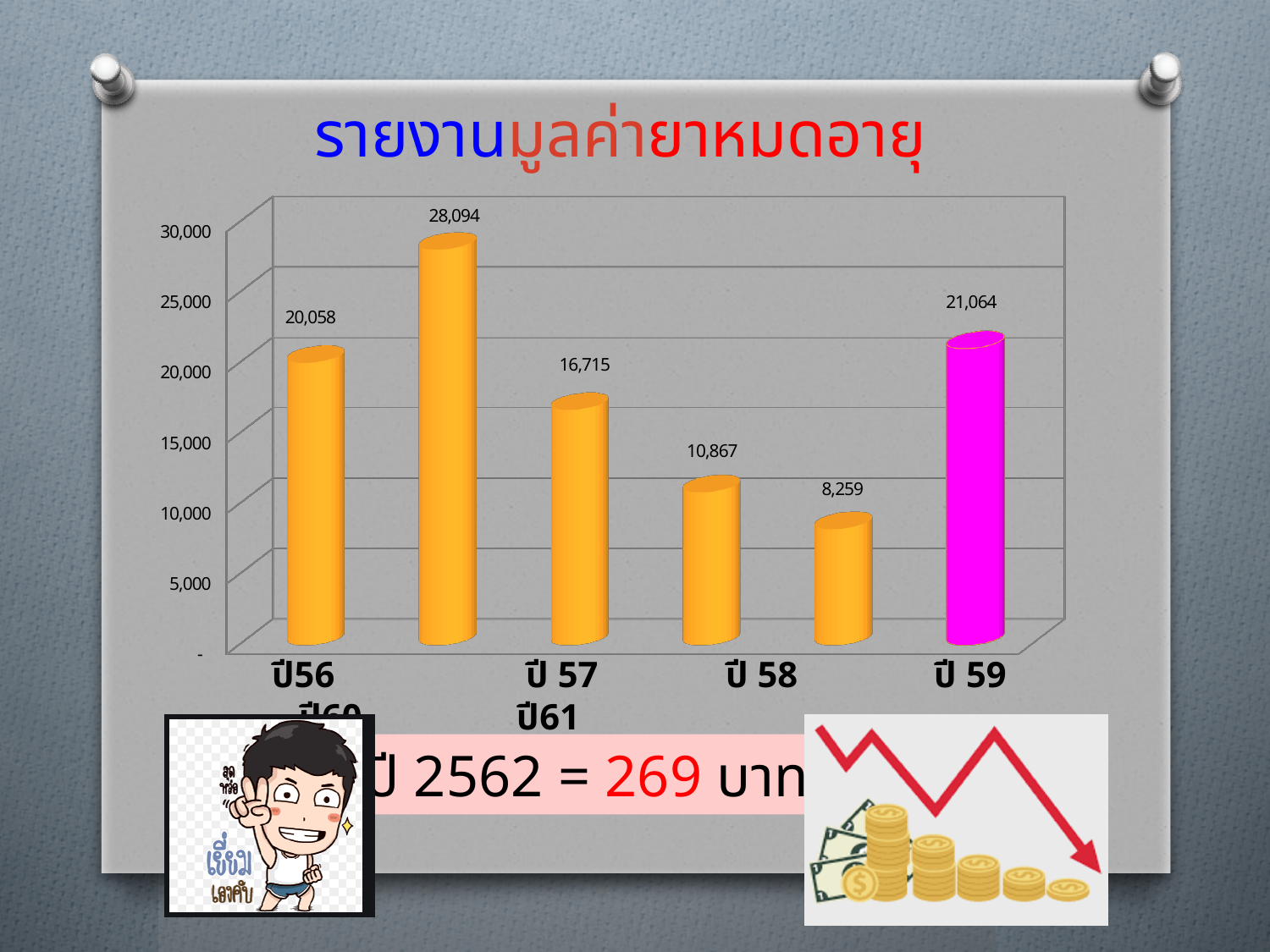
What is the value of the second bar from the left? 28,094 What type of chart is shown on the slide? bar chart What colour is the bar for ปี 59? magenta What is the value of the bar labelled ปี 57? 16,715 What is the difference between the value for ปี 59 and the value for ปี56? 1,006 Which is larger, the value for ปี 57 or the value for ปี 58? ปี 57 What is the value of the first (leftmost) bar, labelled ปี56? 20,058 Which bar has the lowest value? the fifth bar (8,259) What is the value of the magenta bar labelled ปี 59? 21,064 How many bars are plotted in the chart? 6 Which bar has the highest value? the second bar (28,094)